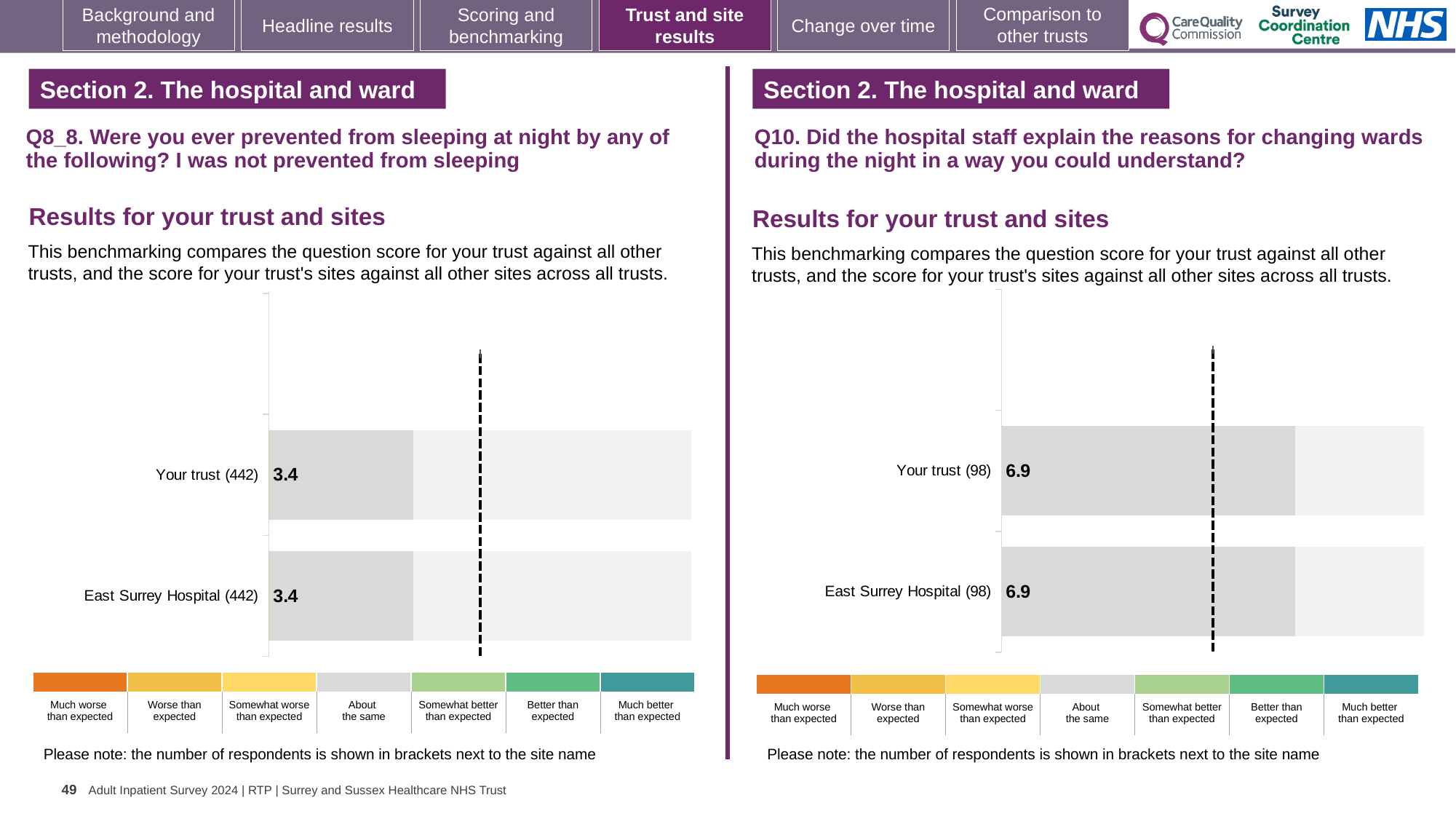
On the Q8_8 chart (left), how many respondents are shown in brackets for Your trust? 442 On the Q10 chart (right), what is the score for East Surrey Hospital? 6.9 How many bars are plotted on the Q8_8 chart (left)? 2 How many bars are plotted on the Q10 chart (right)? 2 On the Q8_8 chart (left), what is the score for East Surrey Hospital? 3.4 On the Q8_8 chart (left), what is the difference between the Your trust score and the East Surrey Hospital score? 0 On the Q8_8 chart (left), what is the score for Your trust? 3.4 What kind of chart is the Q10 chart (right)? Bar chart On the Q10 chart (right), what is the score for Your trust? 6.9 Is the Your trust score on the Q10 chart (right) larger or smaller than the Your trust score on the Q8_8 chart (left)? Larger On the Q10 chart (right), how many respondents are shown in brackets for East Surrey Hospital? 98 On the Q10 chart (right), what is the difference between the Your trust score and the East Surrey Hospital score? 0